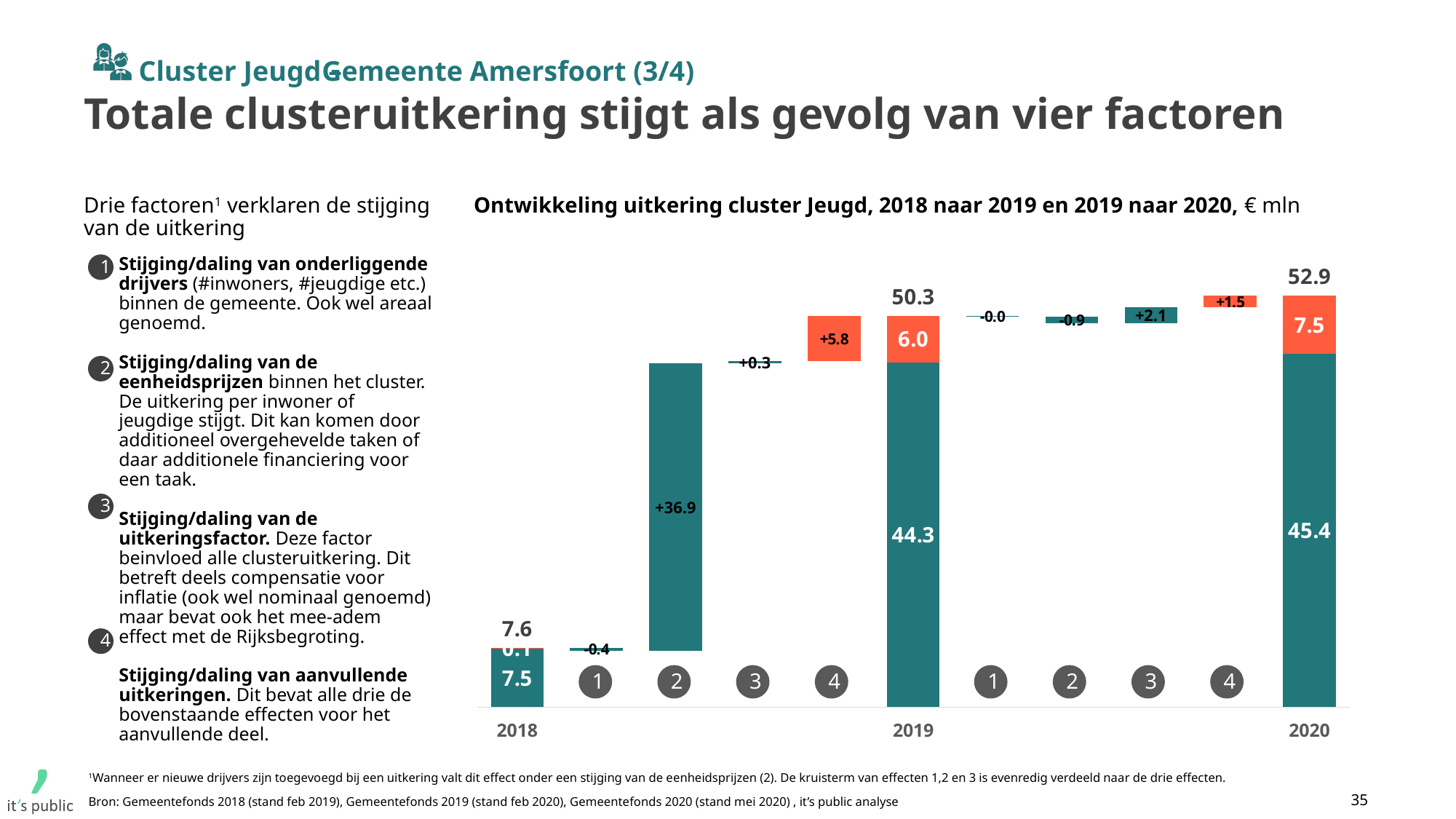
What is the change attributed to factor 2 between 2018 and 2019? +36.9 Which year has the highest total uitkering on the chart? 2020 What is the change attributed to factor 3 between 2019 and 2020? +2.1 What is the value of the teal (lower) segment of the 2019 bar? 44.3 Do the yearly totals rise or fall from 2018 to 2020? rise What is the value of the orange (upper) segment of the 2020 bar? 7.5 What is the total uitkering for cluster Jeugd in 2020 shown on the chart? 52.9 What is the change attributed to factor 2 between 2019 and 2020? -0.9 What is the total uitkering for cluster Jeugd in 2018 shown on the chart? 7.6 What is the total uitkering for cluster Jeugd in 2019 shown on the chart? 50.3 By how much does the total uitkering in 2020 exceed the total in 2019? 2.6 What is the change attributed to factor 4 between 2018 and 2019? +5.8